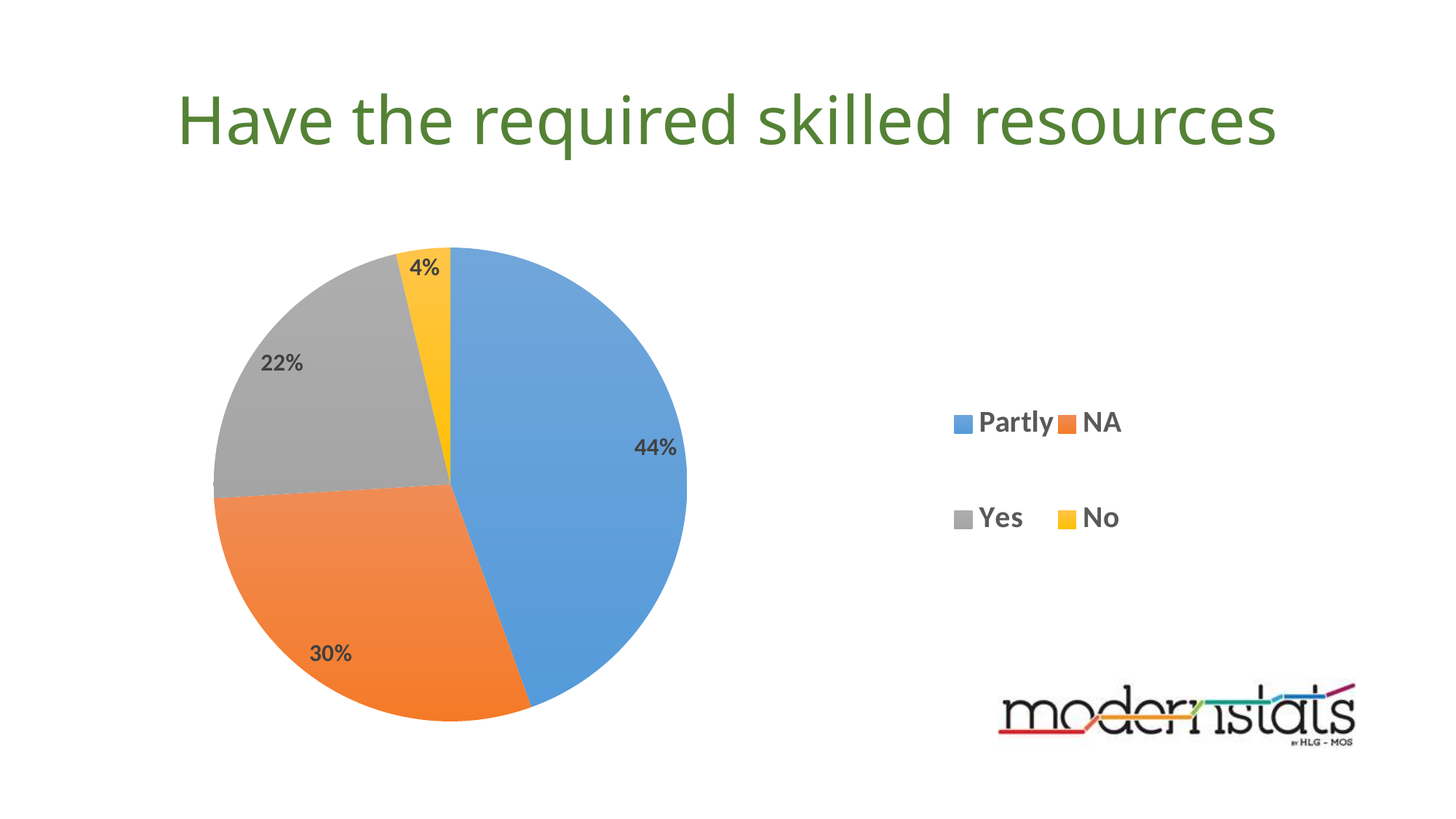
What share of the pie does "Yes" represent? 22% What kind of chart is shown on the slide? pie chart What share of the pie does "NA" represent? 30% What is the difference in percentage points between "Yes" and "No"? 18 What is the difference in percentage points between "Partly" and "NA"? 14 How many categories does the pie chart have? 4 What share of the pie does "Partly" represent? 44% Which is larger, the slice for "Yes" or the slice for "NA"? NA What share of the pie does "No" represent? 4% Which category has the smallest slice of the pie? No What is the title of the slide? Have the required skilled resources Which category has the largest slice of the pie? Partly